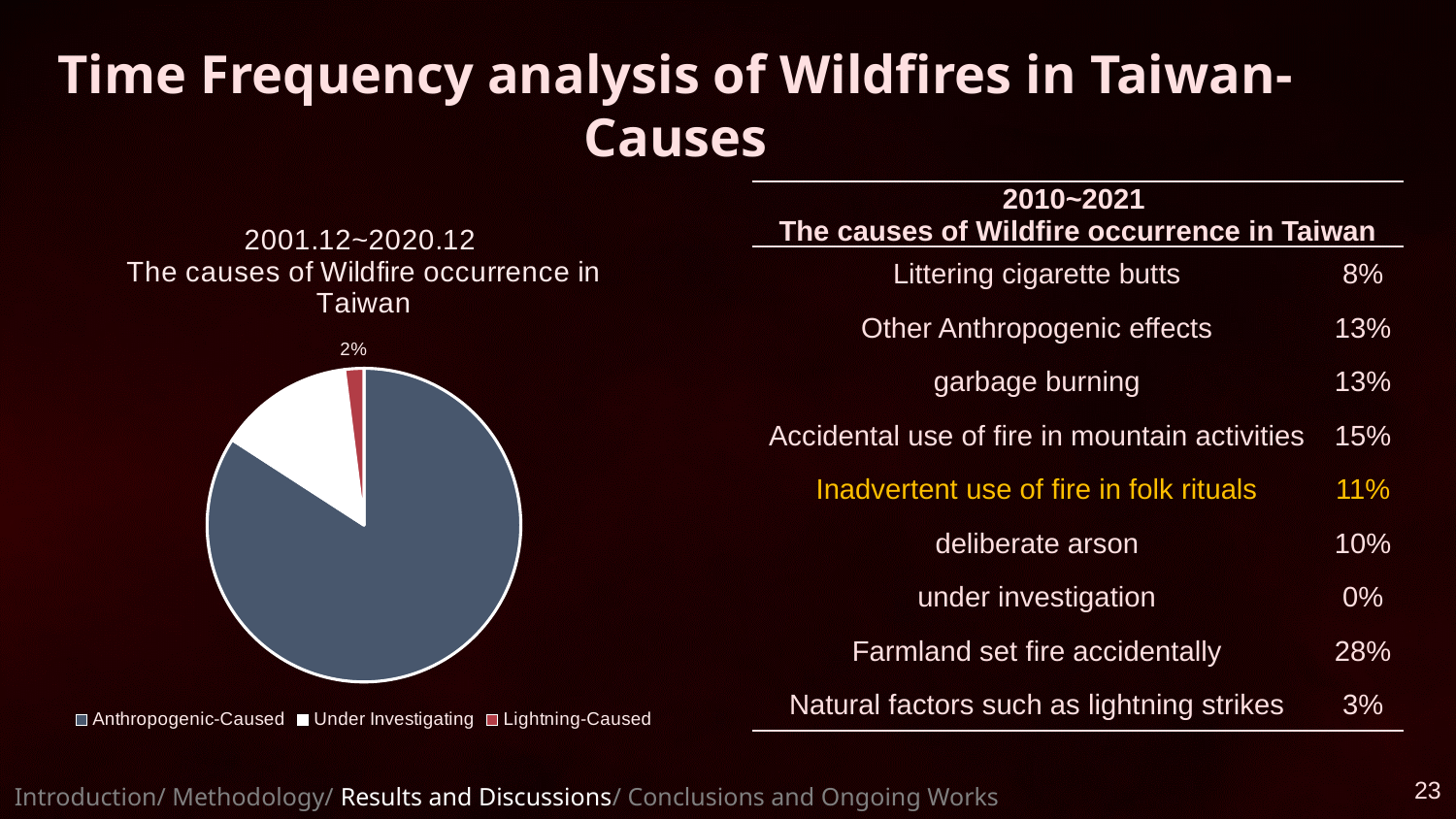
In the pie chart, which is larger: Under Investigating or Lightning-Caused? Under Investigating What time period does the pie chart's title cover? 2001.12~2020.12 How many entries does the legend of the pie chart list? 3 Which category has the smallest slice in the pie chart? Lightning-Caused What share of the pie chart is Lightning-Caused? 2% How many slices does the pie chart have? 3 What kind of chart is shown on the slide? pie chart Which category has the largest slice in the pie chart? Anthropogenic-Caused What colour is the Lightning-Caused slice in the pie chart? red In the pie chart, which is larger: Anthropogenic-Caused or Under Investigating? Anthropogenic-Caused